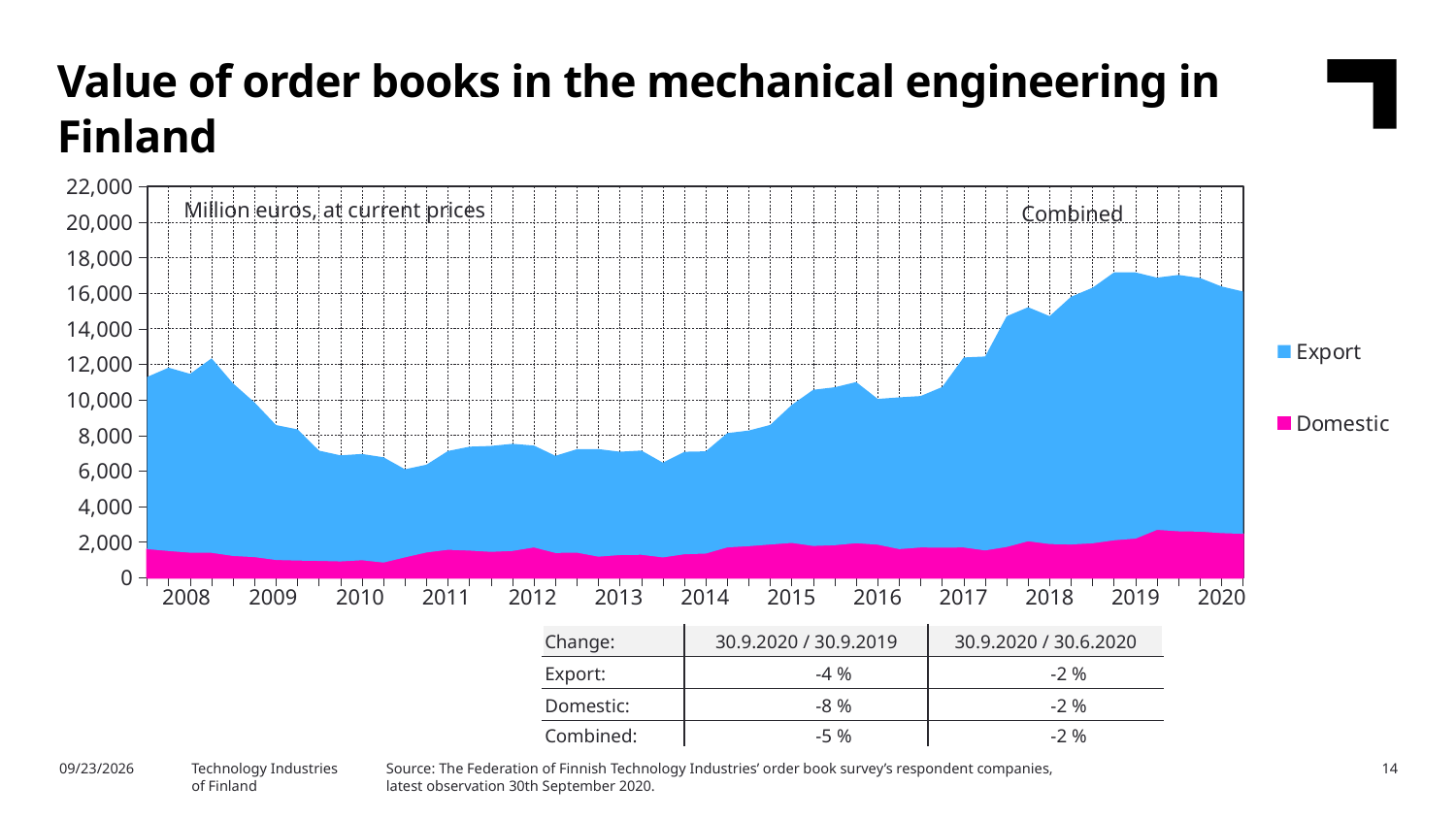
Is the Domestic value of order books in 2013 greater or less than 2,000? less What unit is stated in the chart's annotation at the top left of the plot area? Million euros, at current prices Is the combined value of order books at the start of 2008 greater or less than 10,000? greater How many series does the chart's legend list? 2 Does the combined value of order books rise or fall between 2017 and 2019? rise What kind of chart is shown on the slide? area chart Is the combined value of order books at its 2019 peak greater or less than 16,000? greater According to the table below the chart, what is the Domestic change for 30.9.2020 / 30.9.2019? -8 % What are the two series named in the chart's legend? Export and Domestic According to the table below the chart, what is the Export change for 30.9.2020 / 30.9.2019? -4 % Which year has the higher combined value of order books, 2010 or 2019? 2019